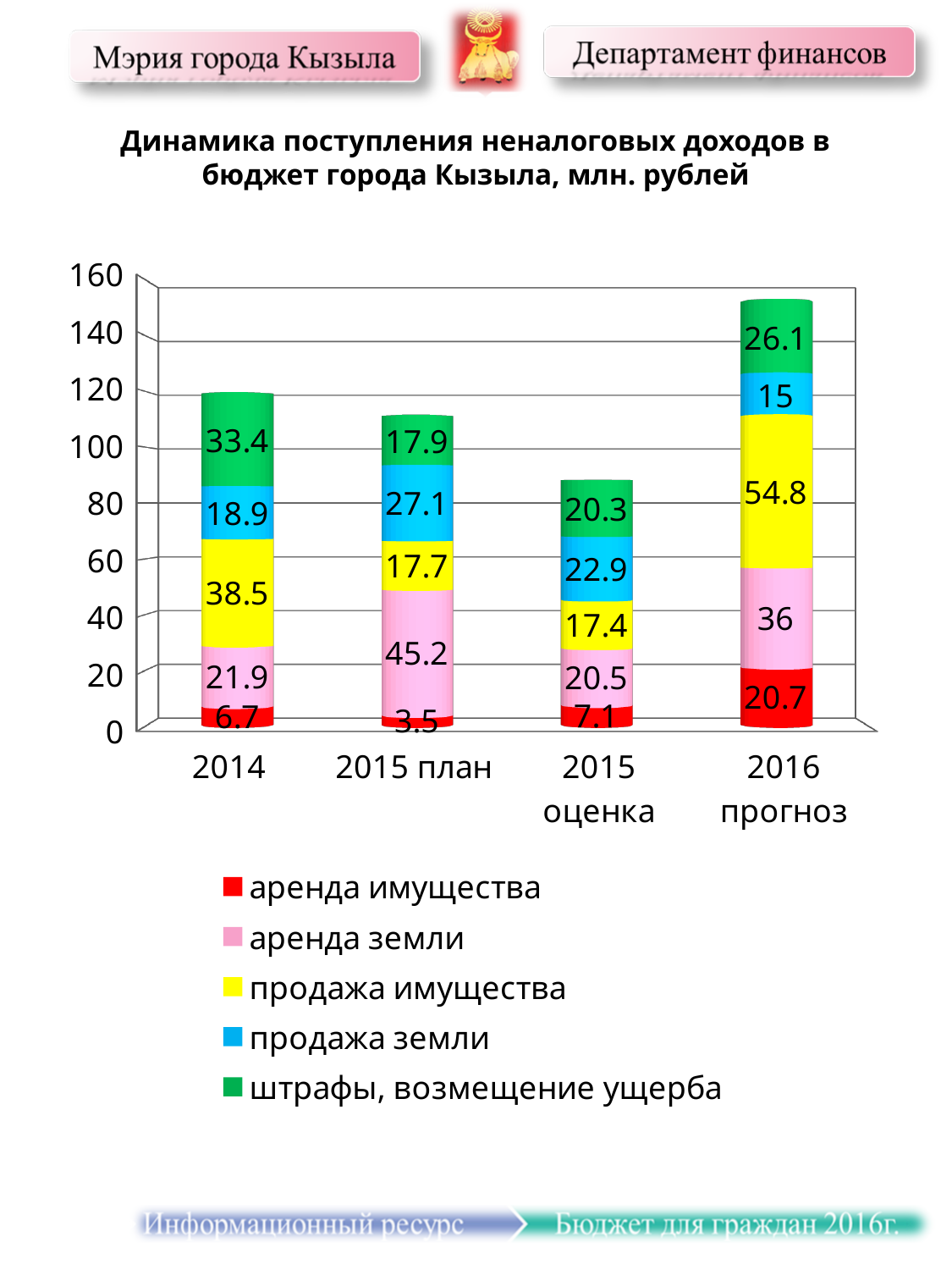
What kind of chart is shown on the slide? Stacked bar chart How many categories are shown on the x axis? 4 How many series does the legend list? 5 Which is larger: аренда земли in 2014 or аренда земли in 2016 прогноз? 2016 прогноз What is the value for штрафы, возмещение ущерба in 2014? 33.4 Which category has the lowest value for аренда имущества? 2015 план What is the value for продажа имущества in 2016 прогноз? 54.8 Which category has the highest value for продажа земли? 2015 план What is the difference between продажа имущества in 2014 and in 2015 оценка? 21.1 What is the value for аренда имущества in 2015 оценка? 7.1 What is the value for аренда земли in 2015 план? 45.2 What is the total of the stacked bar for 2015 оценка? 88.2